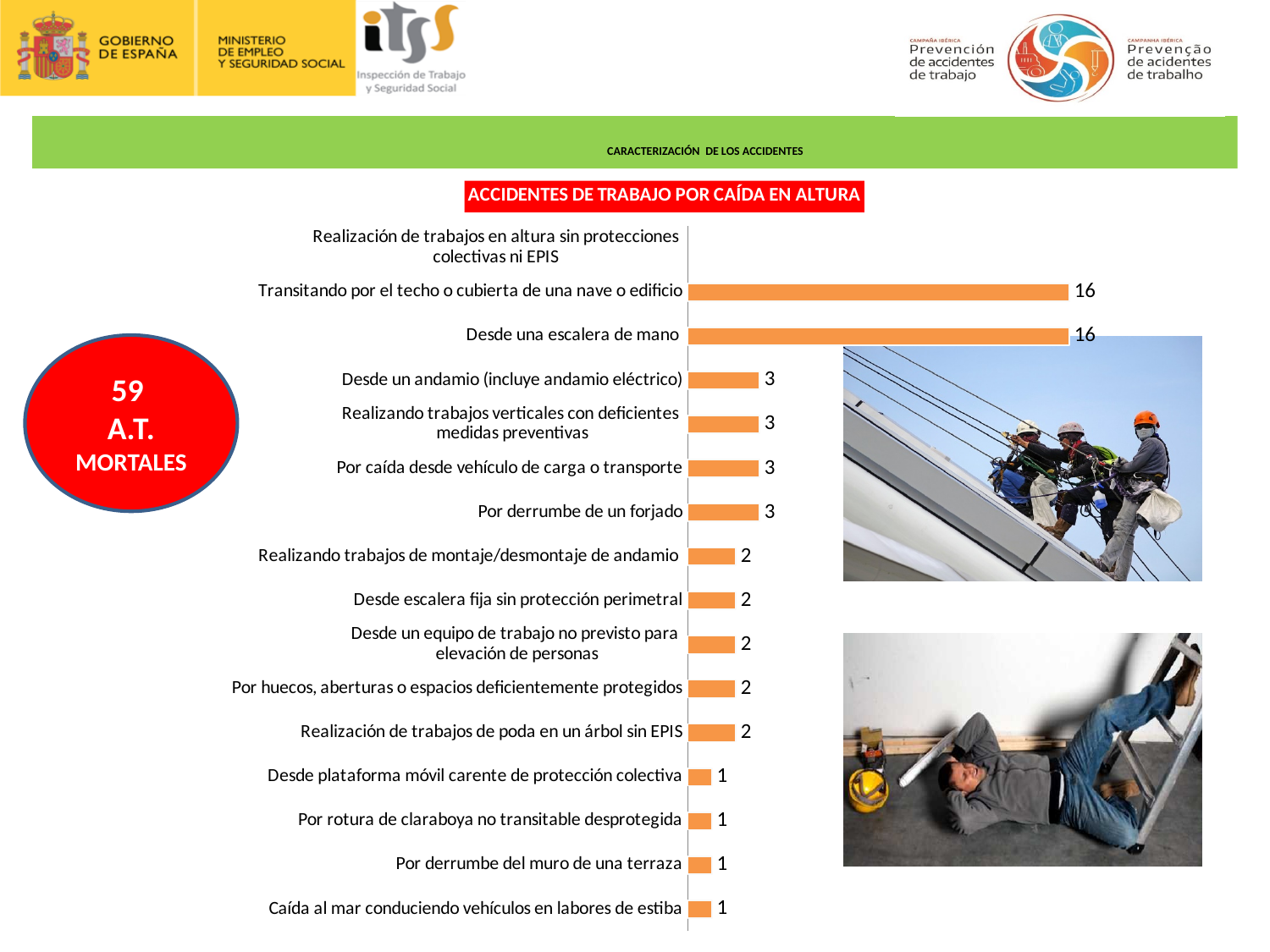
What colour are the bars in the chart? orange What is the value for 'Desde un andamio (incluye andamio eléctrico)'? 3 What is the value for 'Caída al mar conduciendo vehículos en labores de estiba'? 1 What type of chart is shown on the slide? bar chart Which is larger: the value for 'Por caída desde vehículo de carga o transporte' or the value for 'Desde escalera fija sin protección perimetral'? Por caída desde vehículo de carga o transporte What is the title of the chart? ACCIDENTES DE TRABAJO POR CAÍDA EN ALTURA What is the value for 'Desde una escalera de mano'? 16 What is the value for 'Transitando por el techo o cubierta de una nave o edificio'? 16 What is the difference between the value for 'Desde una escalera de mano' and the value for 'Por derrumbe de un forjado'? 13 How many categories are listed on the chart's vertical axis? 16 What is the value for 'Realización de trabajos de poda en un árbol sin EPIS'? 2 What is the difference between the value for 'Por huecos, aberturas o espacios deficientemente protegidos' and the value for 'Por derrumbe del muro de una terraza'? 1